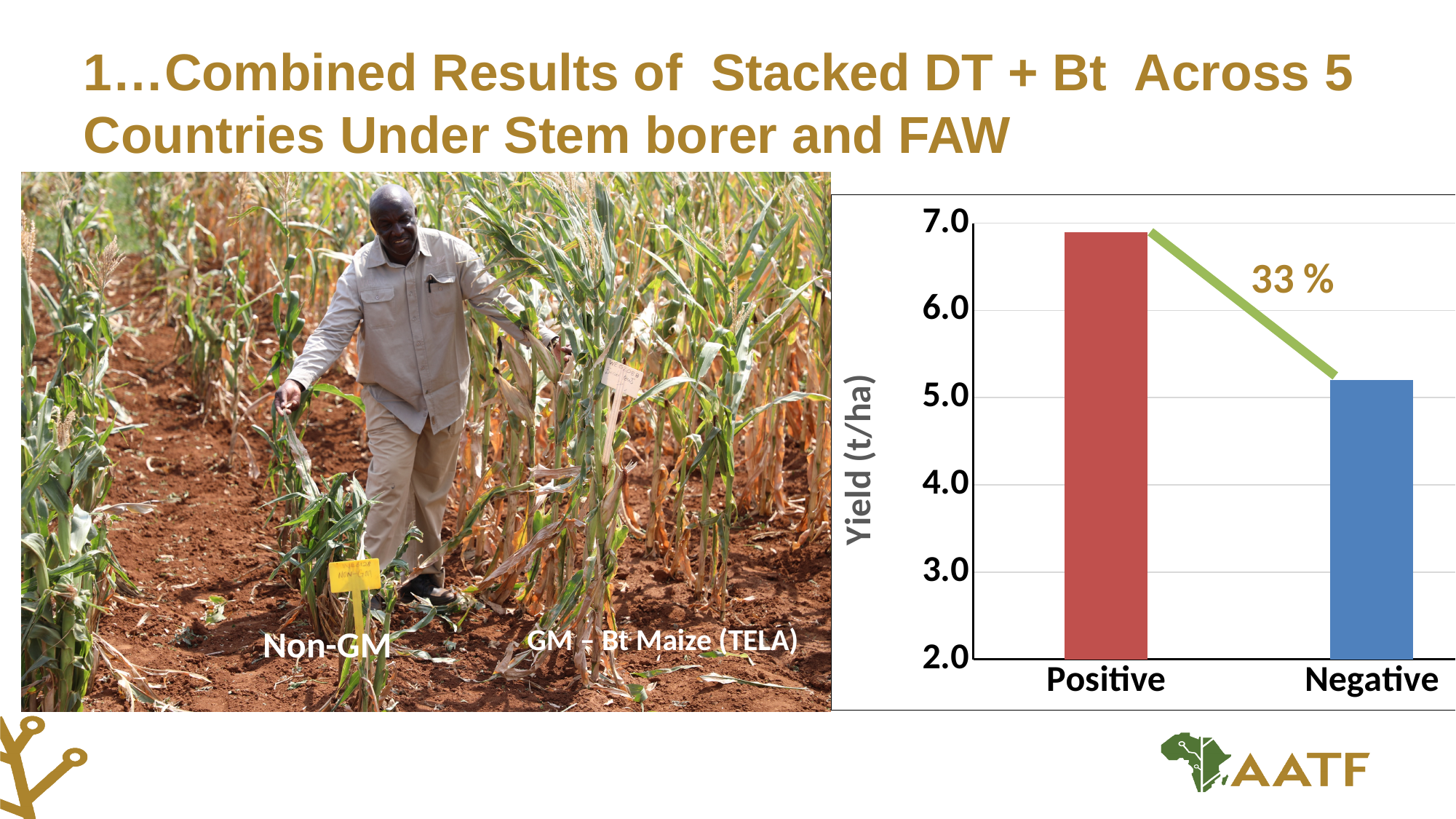
Which bar is taller, Positive or Negative? Positive Which category has the lowest yield in the chart? Negative What kind of chart is shown on the slide? bar chart Is the yield for Negative greater or less than 4.0 t/ha? greater What is the label on the y axis of the chart? Yield (t/ha) Which category has the highest yield in the chart? Positive Is the yield for Positive greater or less than 6.0 t/ha? greater What percentage is annotated next to the green line between the two bars? 33 % How many categories are shown on the x axis of the chart? 2 Is the yield for Negative greater or less than 6.0 t/ha? less